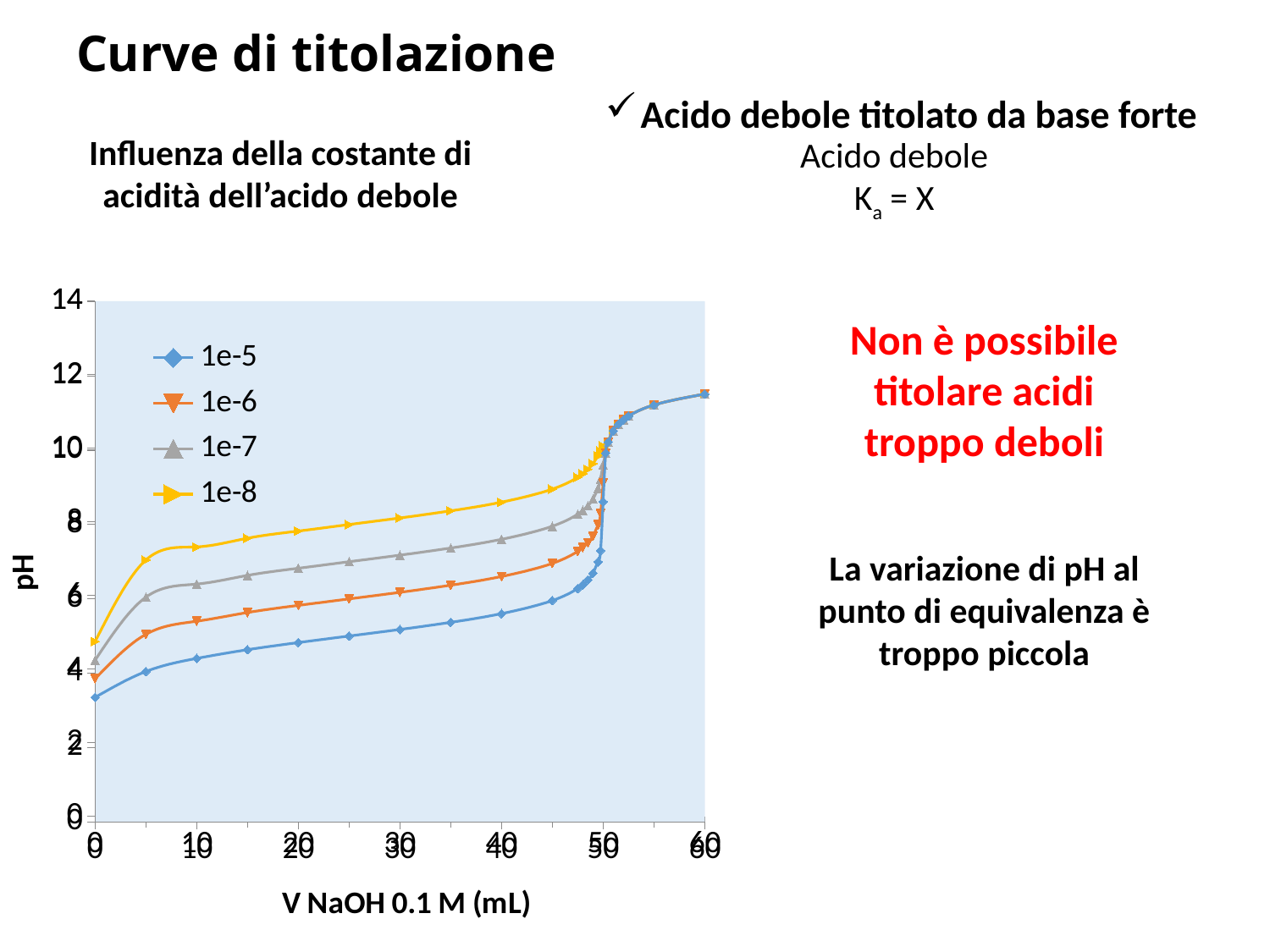
Is the pH of the 1e-8 series at 40 mL of NaOH greater or less than 8? greater Is the pH of the 1e-6 series at 60 mL of NaOH greater or less than 10? greater Is the pH of the 1e-5 series at 0 mL of NaOH greater or less than 4? less Which series has the highest pH at 0 mL of NaOH? 1e-8 How many series does the legend list? 4 What is the title of the y axis of the chart? pH Do the pH values rise or fall as the volume of NaOH increases along the x axis? rise Which series has the lowest pH at 0 mL of NaOH? 1e-5 At 20 mL of NaOH, which series has the higher pH, 1e-8 or 1e-5? 1e-8 What is the title of the x axis of the chart? V NaOH 0.1 M (mL) What kind of chart is shown on the slide? line chart